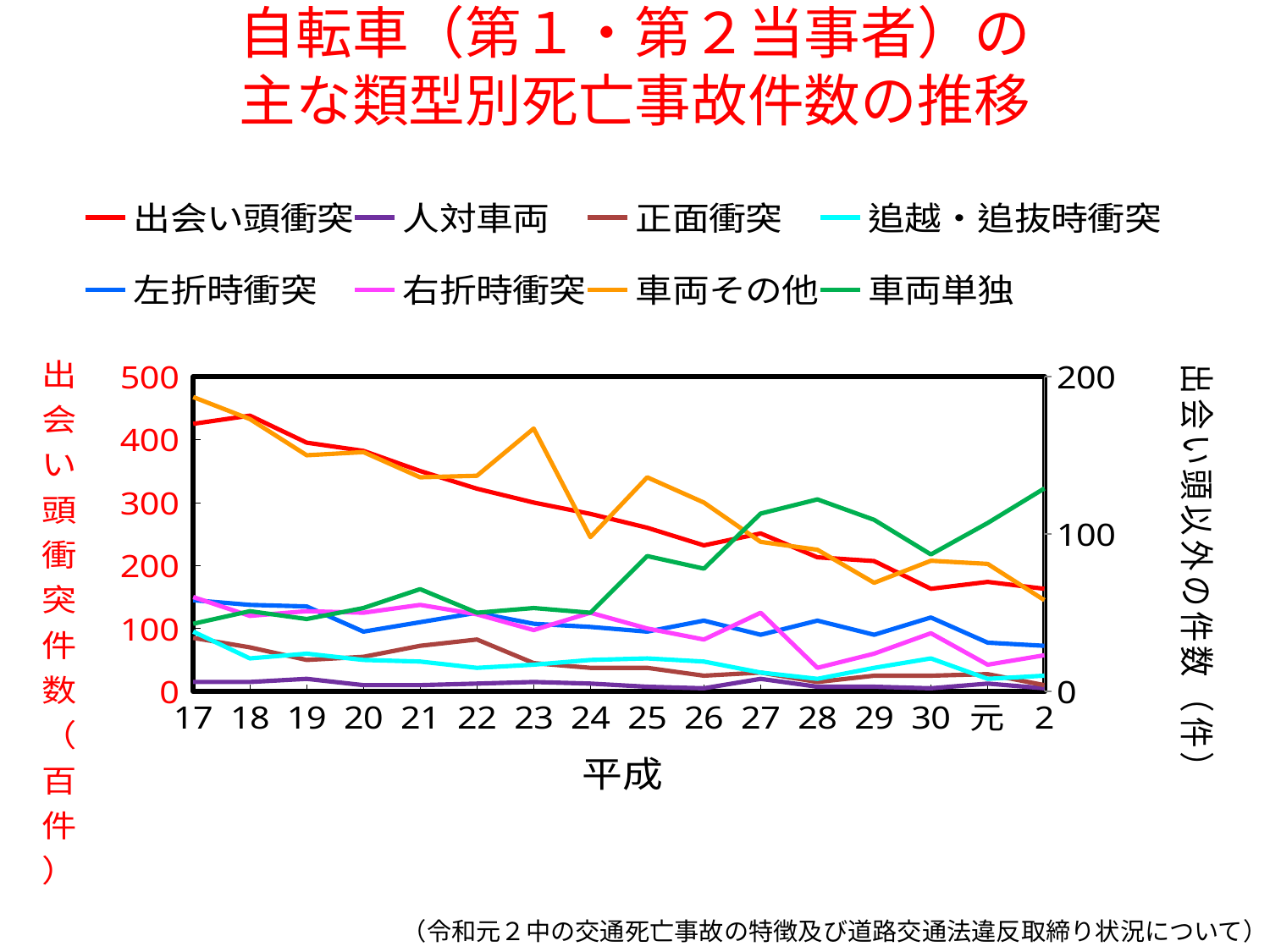
Does the value for 車両単独 rise or fall overall from 17 to 2? rise Is the value for 出会い頭衝突 at 17 (left axis) greater or less than 400? greater Is the value for 車両単独 at 2 (right axis) greater or less than 100? greater What kind of chart is shown on the slide? line chart How many points are plotted along the x axis (from 17 to 2)? 16 At 17, which is larger: 車両その他 or 車両単独? 車両その他 Is the value for 出会い頭衝突 at 2 (left axis) greater or less than 200? less Does the value for 出会い頭衝突 rise or fall overall from 17 to 2? fall What is the title of the x axis? 平成 At 2, which is larger: 車両単独 or 車両その他? 車両単独 How many series does the legend list? 8